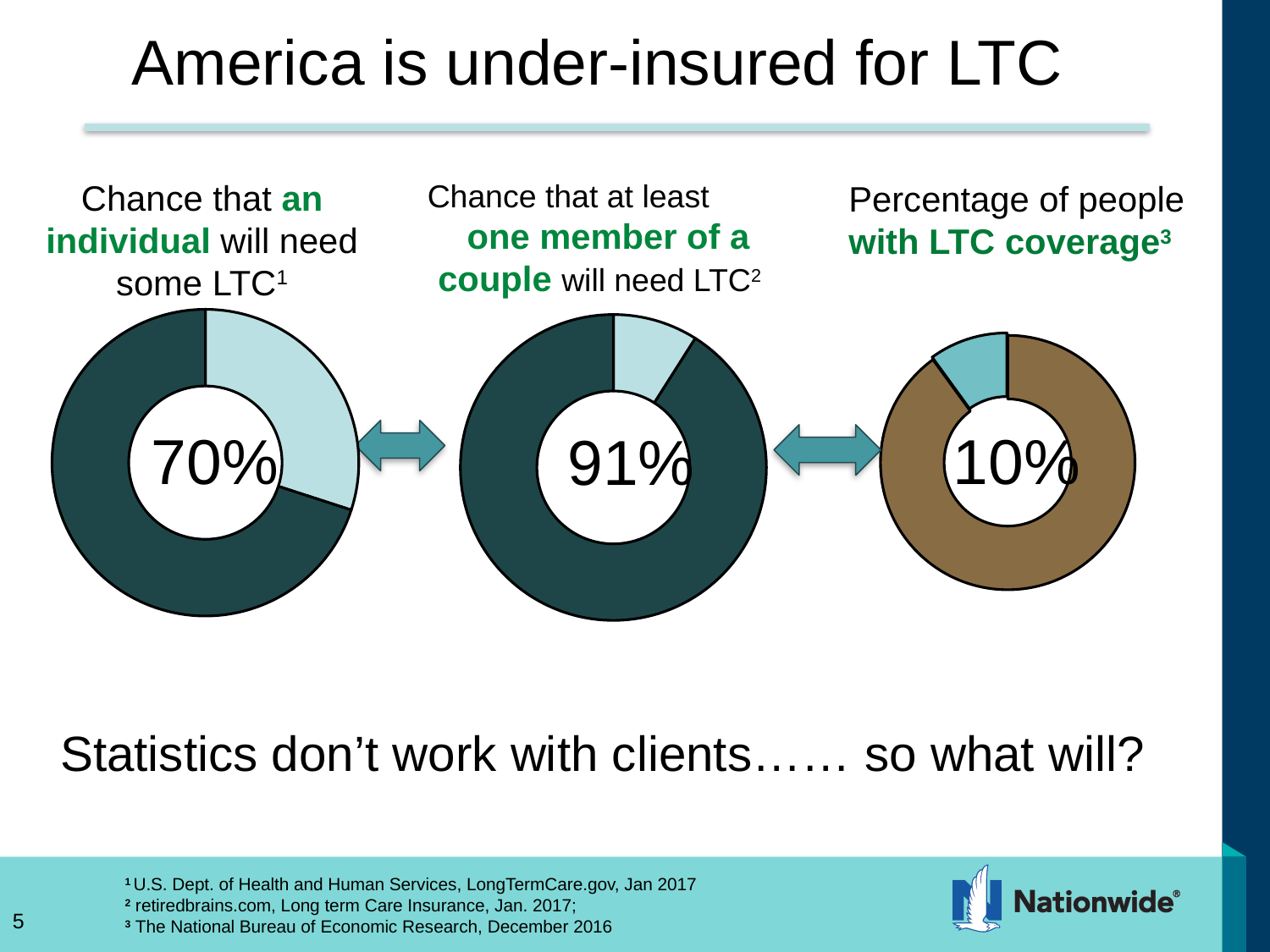
Which of the three charts shows the highest percentage? Chance that at least one member of a couple will need LTC (91%) In the middle chart, what is the chance that at least one member of a couple will need LTC? 91% Which is larger: the chance an individual will need some LTC or the chance at least one member of a couple will need LTC? At least one member of a couple (91%) What kind of chart is used for the three figures on the slide? Donut (pie) chart What is the difference in percentage points between the chance an individual will need some LTC (70%) and the percentage of people with LTC coverage (10%)? 60 percentage points How many donut charts are shown on the slide? 3 In the right chart, what percentage of people have LTC coverage? 10% What is the difference in percentage points between the couple chart (91%) and the individual chart (70%)? 21 percentage points In the left chart, what is the chance that an individual will need some LTC? 70% How many slices does each donut chart have? 2 Which of the three charts shows the lowest percentage? Percentage of people with LTC coverage (10%) What colour is the large slice in the right-hand chart showing the percentage of people with LTC coverage? Brown